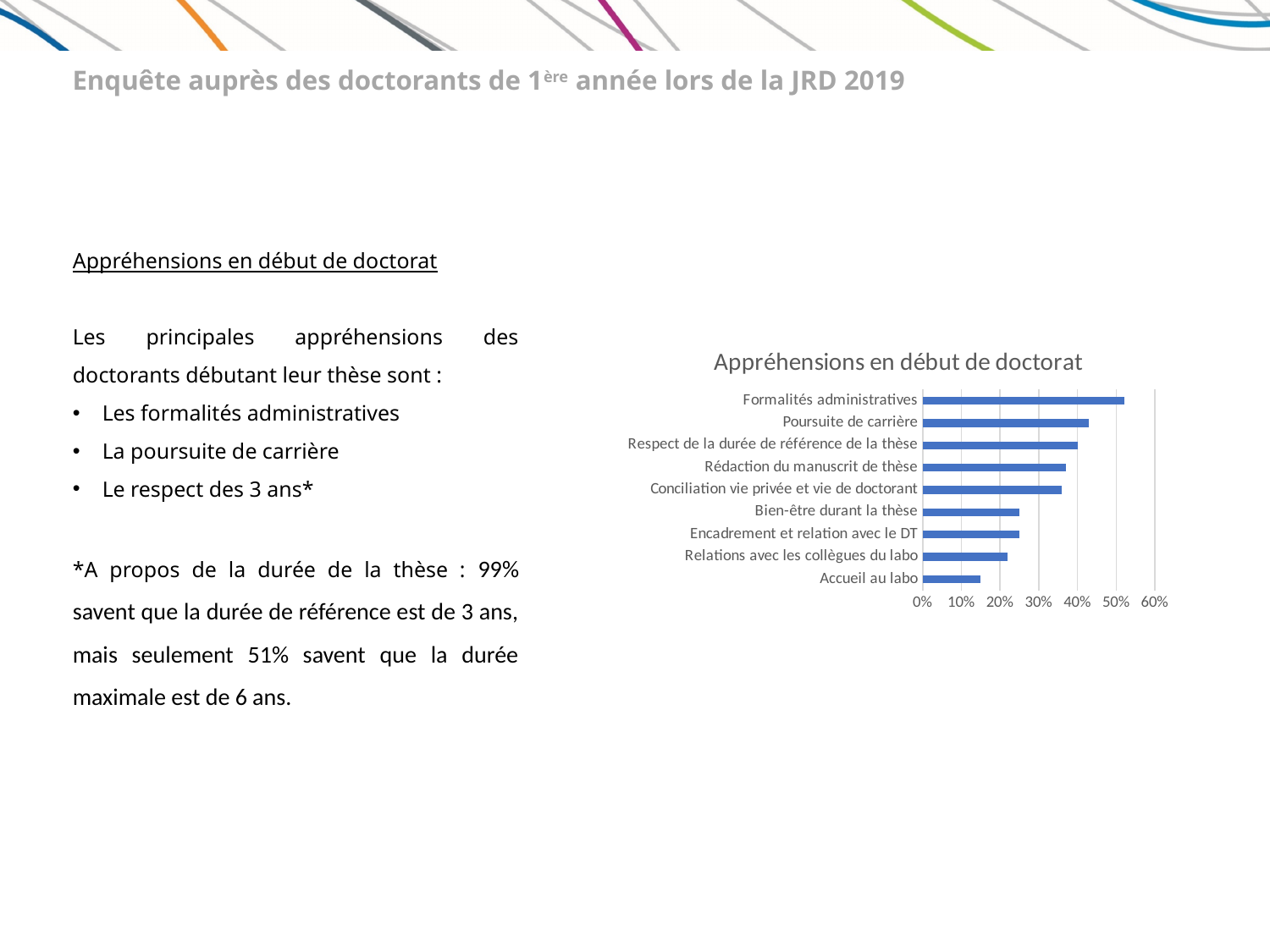
Is the value for Formalités administratives greater or less than 50%? greater Which category has the lowest value in the chart? Accueil au labo Is the value for Poursuite de carrière greater or less than 40%? greater Which is larger, the value for Poursuite de carrière or the value for Bien-être durant la thèse? Poursuite de carrière What kind of chart is shown on the slide? bar chart What is the title of the chart? Appréhensions en début de doctorat Is the value for Relations avec les collègues du labo greater or less than 30%? less Which is larger, the value for Accueil au labo or the value for Conciliation vie privée et vie de doctorant? Conciliation vie privée et vie de doctorant How many categories are plotted in the chart? 9 Which category has the highest value in the chart? Formalités administratives What is the highest value shown on the horizontal axis of the chart? 60%